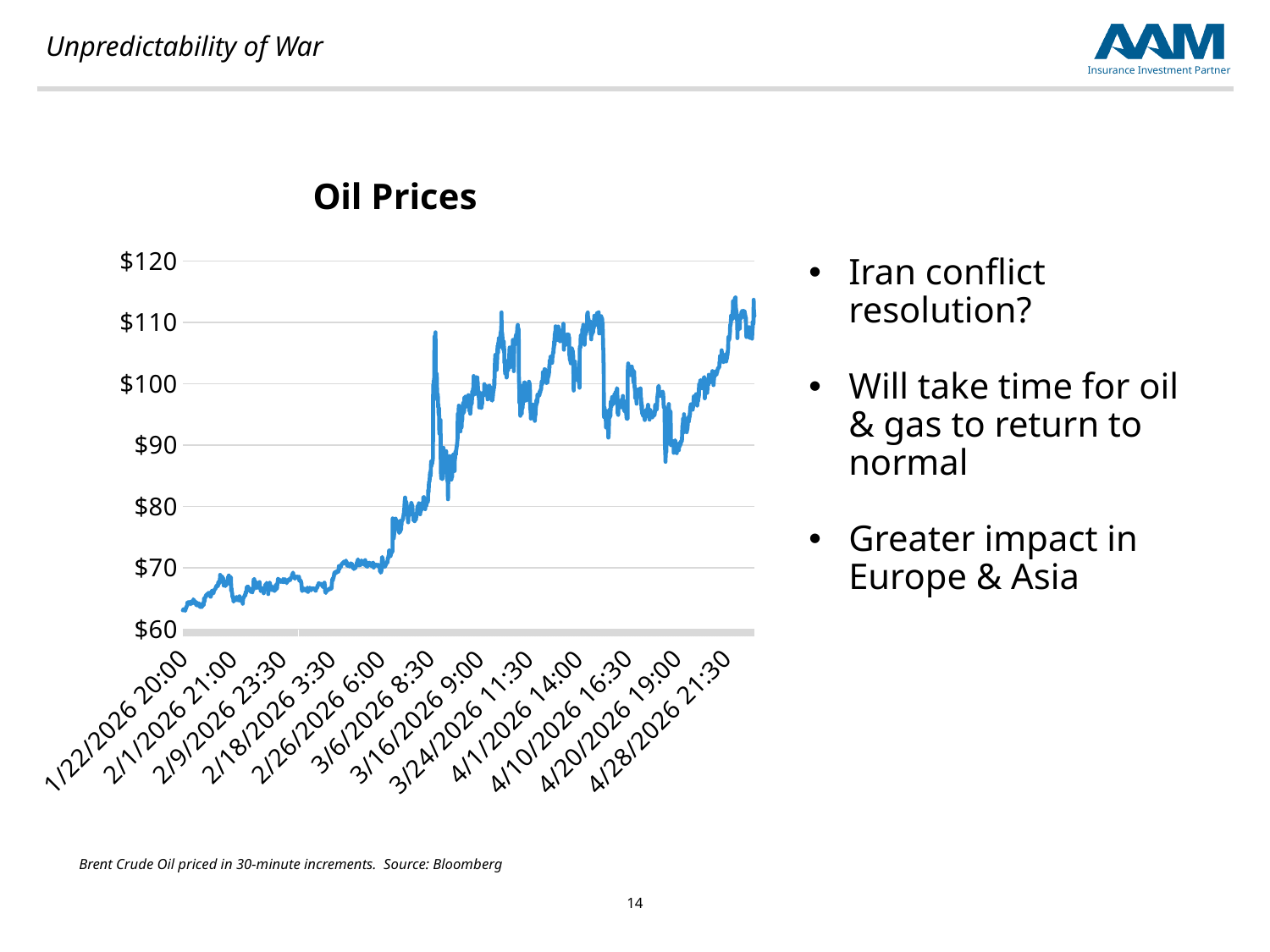
Is the value at 4/28/2026 21:30 greater or less than $100? greater Overall, do oil prices rise or fall from the left of the x axis to the right? rise What is the title of the chart? Oil Prices Is the value at 4/1/2026 14:00 greater or less than $100? greater How many date labels are shown on the x axis? 12 Is the highest point on the line greater or less than $110? greater What is the highest value shown on the y axis? $120 Is the value at 4/1/2026 14:00 larger or smaller than the value at 1/22/2026 20:00? larger What kind of chart is shown on the slide? line chart